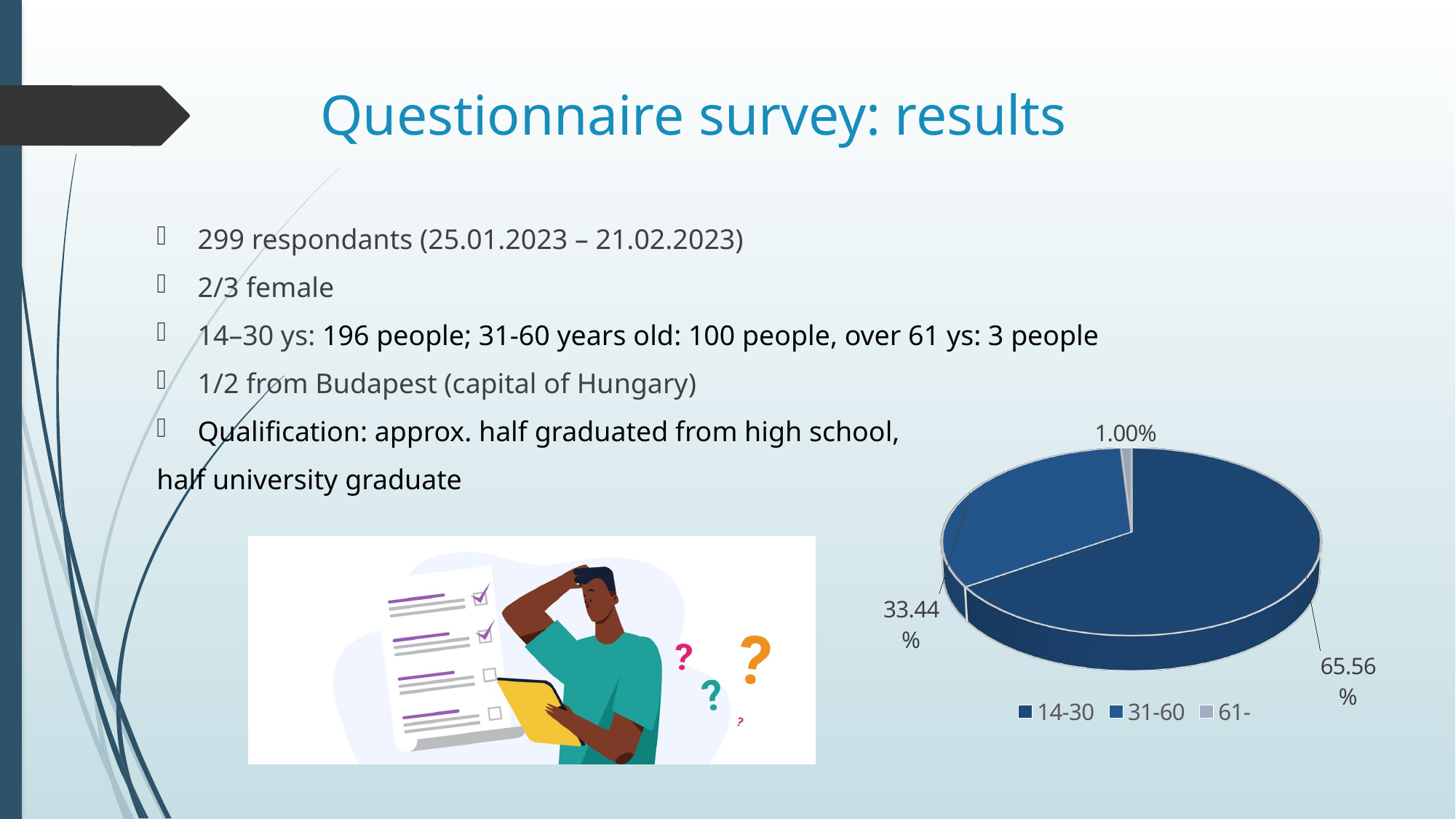
What share of the pie does the 14-30 age group have? 65.56% What kind of chart is shown on the slide? pie chart Which age group has the largest slice of the pie? 14-30 How many slices does the pie chart have? 3 What share of the pie does the 31-60 age group have? 33.44% Which age group has the smallest slice of the pie? 61- What is the difference in percentage points between the 14-30 and 31-60 slices? 32.12 What is the combined share of the 31-60 and 61- slices? 34.44% What are the legend entries of the pie chart? 14-30, 31-60, 61- Which slice is larger, 31-60 or 61-? 31-60 What share of the pie does the 61- age group have? 1.00% How many entries does the legend of the pie chart list? 3